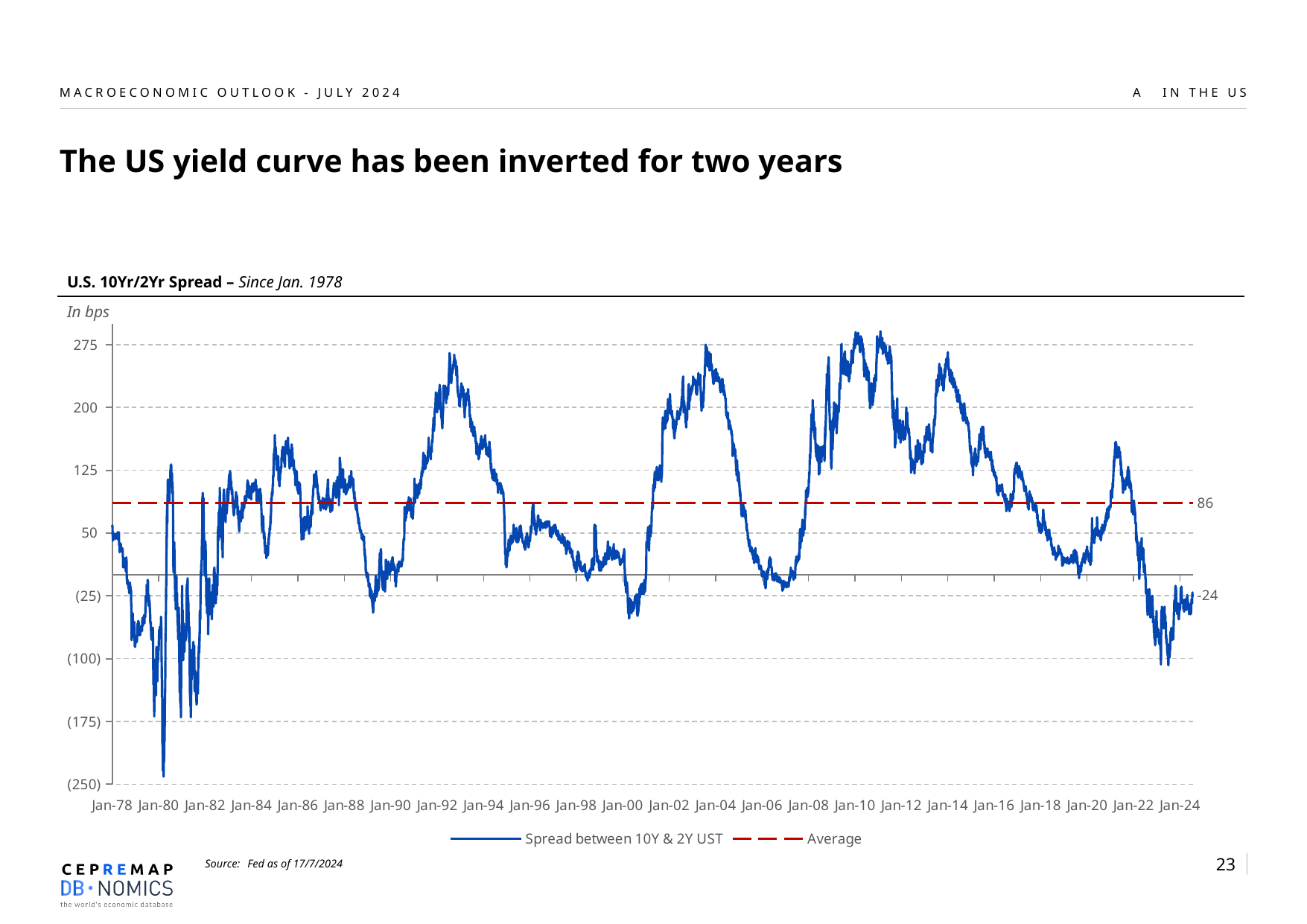
What kind of chart is shown on the slide? line chart Is the value of the spread around Jan-96 greater or less than 125? less Does the spread rise or fall between Jan-22 and Jan-24? fall In what unit are the values on the chart expressed? In bps What is the title of the chart? U.S. 10Yr/2Yr Spread – Since Jan. 1978 What is the latest value of the spread between 10Y & 2Y UST, as labelled at the right end of the line? -24 Is the peak of the spread reached around Jan-92 greater or less than 200? greater What is the value of the Average line, as labelled on the right of the chart? 86 Is the lowest value of the spread reached around 1980 greater or less than (175)? less What is the difference between the Average (86) and the latest spread value (-24)? 110 Which is larger: the latest spread value (-24) or the Average (86)? Average How many series does the legend list? 2